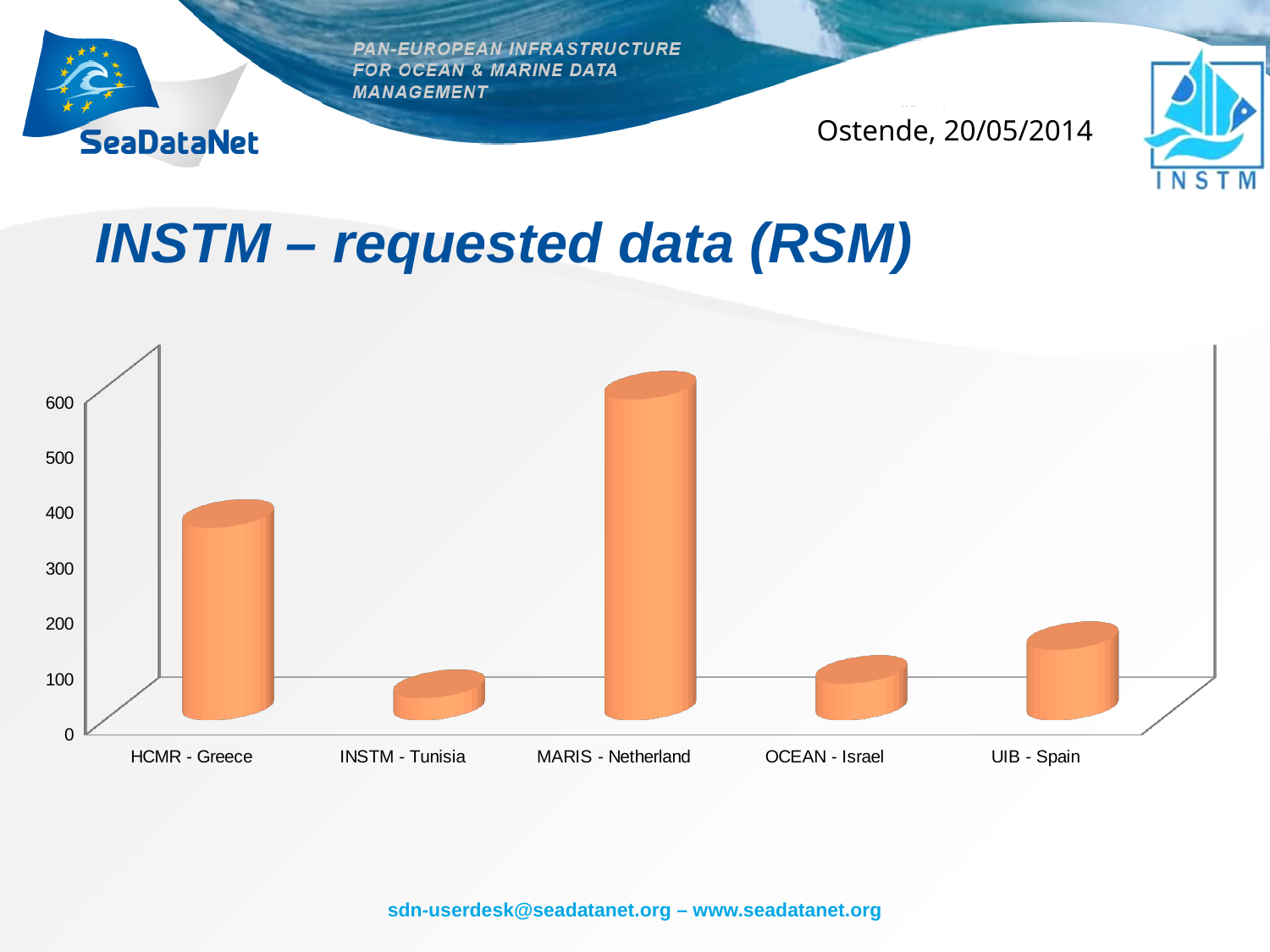
Is the value for INSTM - Tunisia greater or less than 200? less Is the value for OCEAN - Israel greater or less than 300? less Is the value for MARIS - Netherland greater or less than 500? greater What is the highest value labelled on the vertical axis of the chart? 600 What is the title of the chart on the slide? INSTM – requested data (RSM) Which is larger, the value for MARIS - Netherland or the value for HCMR - Greece? MARIS - Netherland What kind of chart is shown on the slide? bar chart How many categories are shown on the x axis of the chart? 5 Which category has the highest value in the chart? MARIS - Netherland Which is larger, the value for HCMR - Greece or the value for UIB - Spain? HCMR - Greece